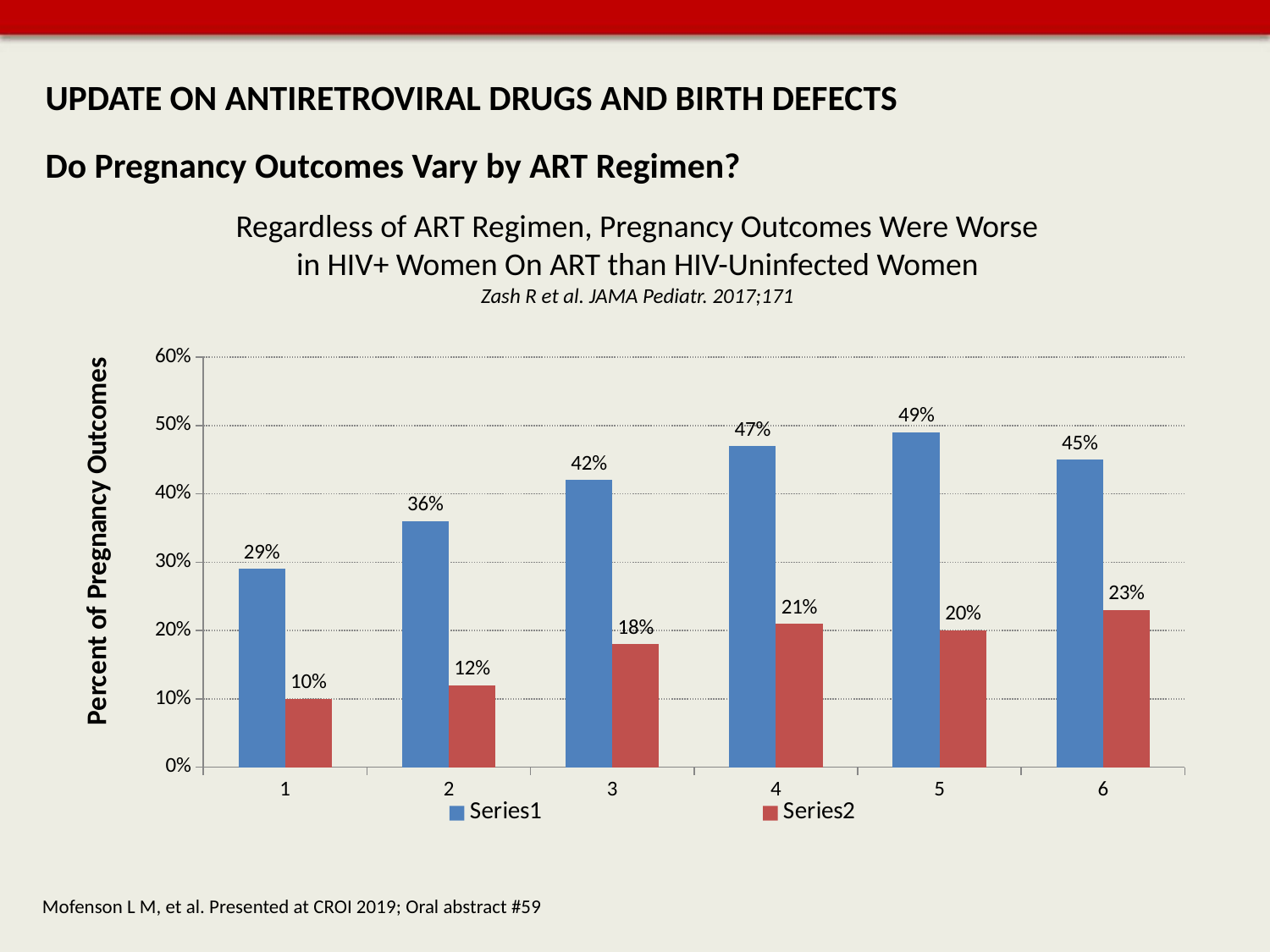
How many series does the legend list? 2 Does the Series1 value rise or fall from category 1 to category 5? Rise Which category has the lowest Series2 value? 1 What colour are the Series2 bars? Red What kind of chart is shown on the slide? Bar chart How many categories are shown on the x axis? 6 What is the value of Series2 for category 6? 23% What is the value of Series1 for category 3? 42% Which is larger for category 2: Series1 or Series2? Series1 What is the y-axis label of the chart? Percent of Pregnancy Outcomes What is the difference between Series1 and Series2 for category 4? 26% Which category has the highest Series1 value? 5